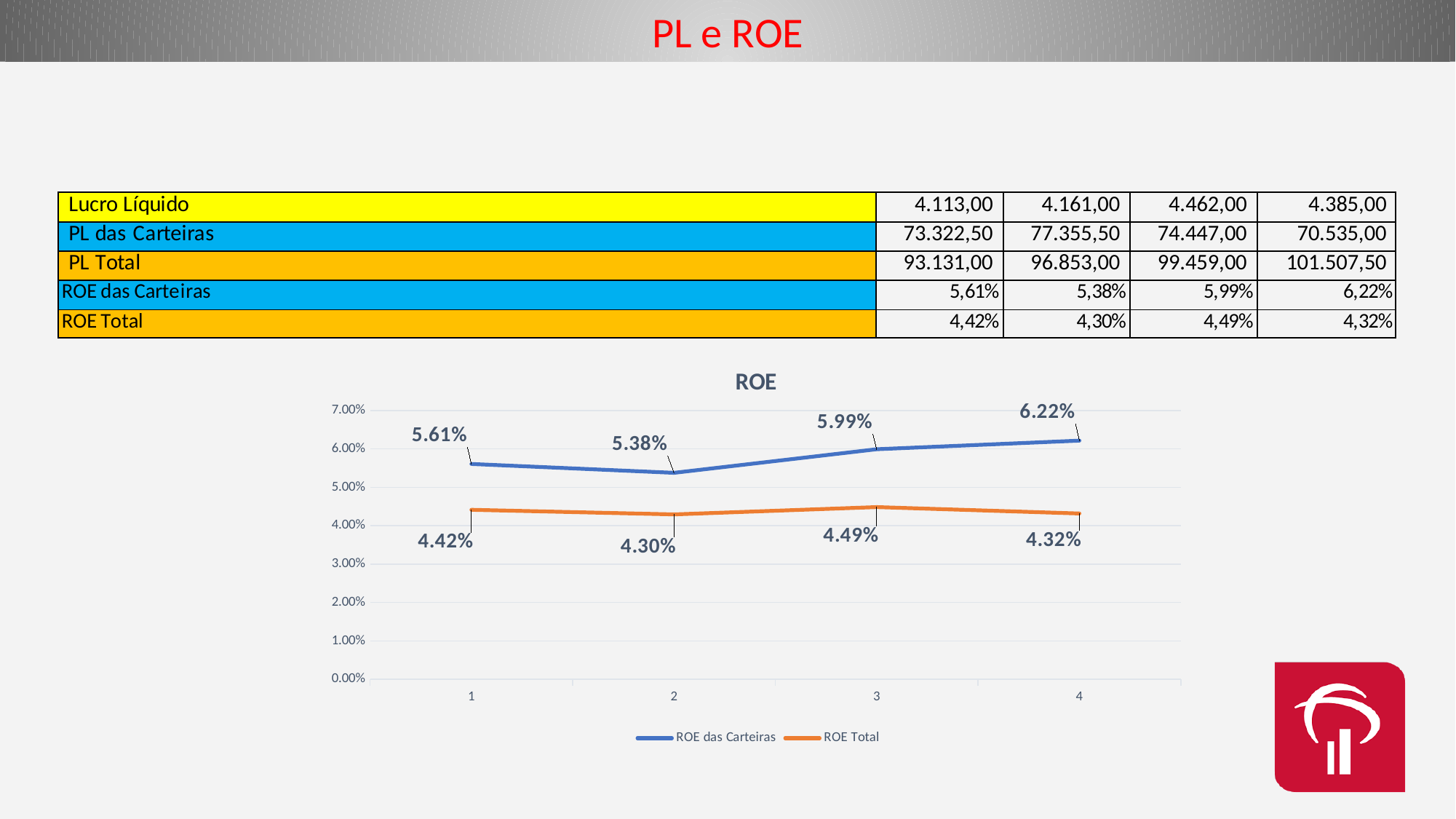
At which point is ROE das Carteiras highest in the ROE chart? 4 Which is larger at point 2 in the ROE chart: ROE das Carteiras or ROE Total? ROE das Carteiras At which point is ROE Total lowest in the ROE chart? 2 Does ROE das Carteiras rise or fall from point 2 to point 4 in the ROE chart? rise What is the difference between ROE das Carteiras and ROE Total at point 4 in the ROE chart? 1.90% What is the ROE Total value at point 3 in the ROE chart? 4.49% How many points are plotted along the x axis of the ROE chart? 4 What is the ROE das Carteiras value at point 1 in the ROE chart? 5.61% What type of chart is the ROE chart? line chart What is the ROE das Carteiras value at point 4 in the ROE chart? 6.22% How many series does the legend of the ROE chart list? 2 Is the ROE das Carteiras value at point 3 greater or less than 5.00%? greater